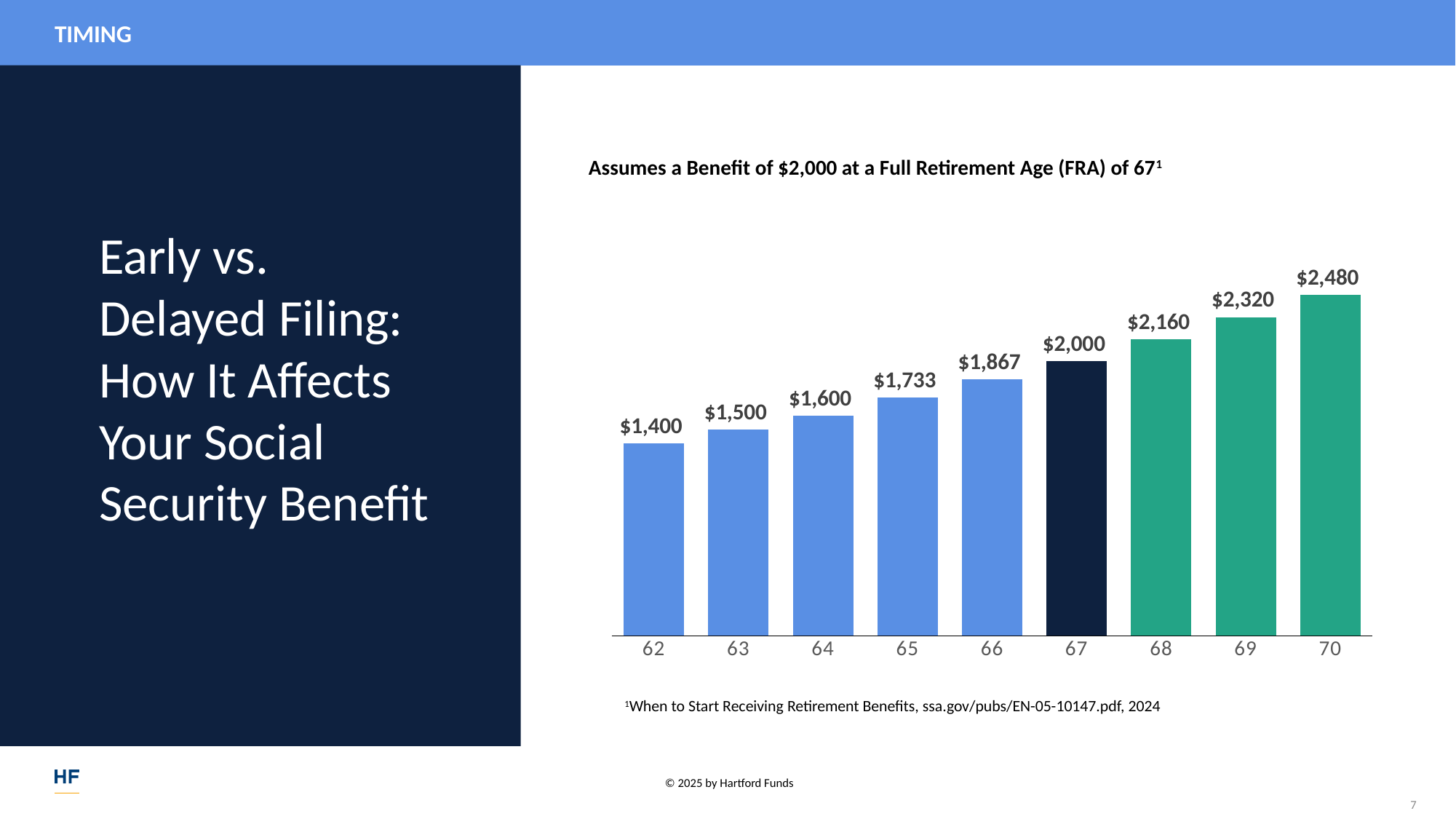
What kind of chart is shown? Bar chart Which age has the lowest benefit? 62 What is the monthly benefit shown for filing at age 62? $1,400 Do the benefit values rise or fall as age increases from 62 to 70? Rise What is the benefit shown for age 70? $2,480 What is the benefit shown for age 65? $1,733 What is the difference between the benefit at age 70 and the benefit at age 62? $1,080 Which age has the highest benefit? 70 What is the difference between the benefit at age 68 and the benefit at age 67? $160 Which is larger, the benefit at age 66 or the benefit at age 69? 69 What is the benefit shown for age 67? $2,000 How many ages are shown on the x axis? 9